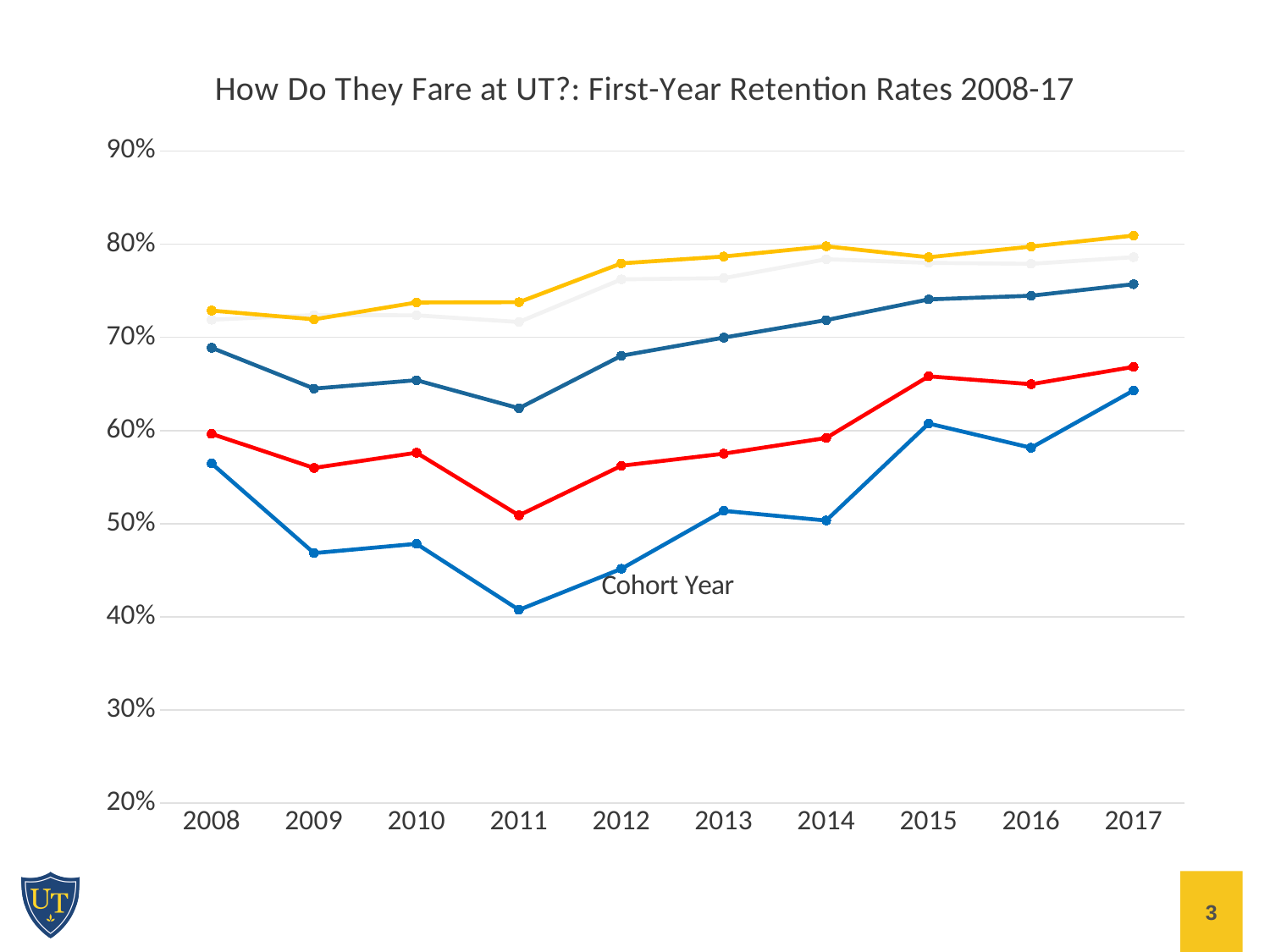
Is the value of the bright blue line in 2011 greater or less than 50%? less Which line is higher in 2017, the yellow line or the red line? the yellow line What is the title of the chart? How Do They Fare at UT?: First-Year Retention Rates 2008-17 Is the value of the yellow line in 2017 greater or less than 80%? greater In which year does the bright blue (lowest) line reach its lowest point? 2011 Is the value of the red line in 2017 greater or less than 70%? less In which year does the yellow (top) line reach its highest point? 2017 How many cohort years are plotted along the x axis? 10 Does the bright blue line rise or fall overall from 2011 to 2017? rise What kind of chart is shown on the slide? line chart What label is shown for the x axis of the chart? Cohort Year